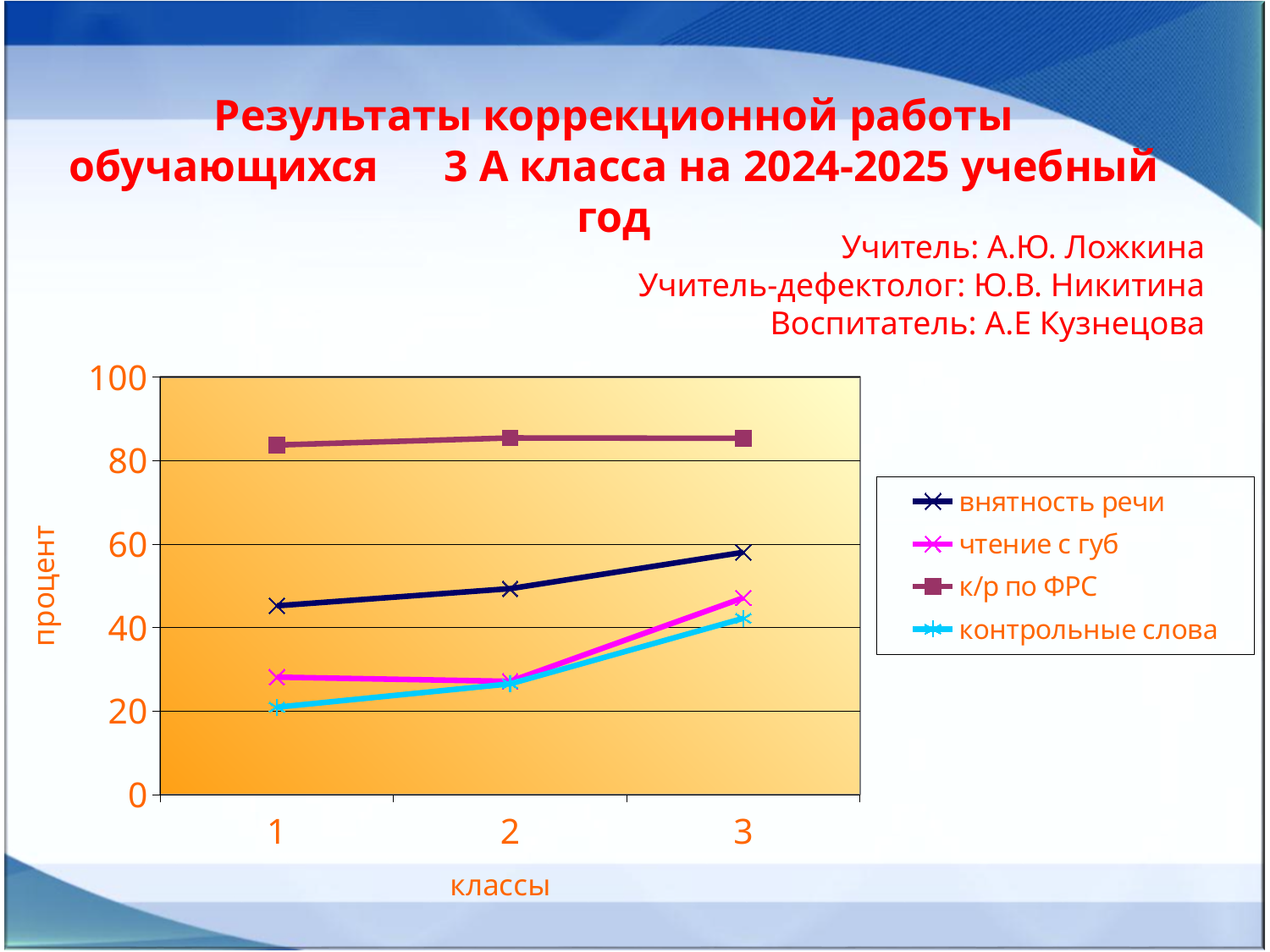
Is the value for контрольные слова at class 1 greater or less than 40? less What kind of chart is shown on the slide? line chart What is the title of the vertical axis? процент Which series has the highest values across all classes? к/р по ФРС How many points (classes) are plotted along the x axis? 3 Does the внятность речи series rise or fall from class 1 to class 3? rises Is the value for к/р по ФРС at class 2 greater or less than 80? greater What is the title of the horizontal axis? классы How many series does the legend list? 4 Which series has the lowest value at class 1? контрольные слова Which is larger at class 3: внятность речи or чтение с губ? внятность речи Is the value for внятность речи at class 3 greater or less than 40? greater